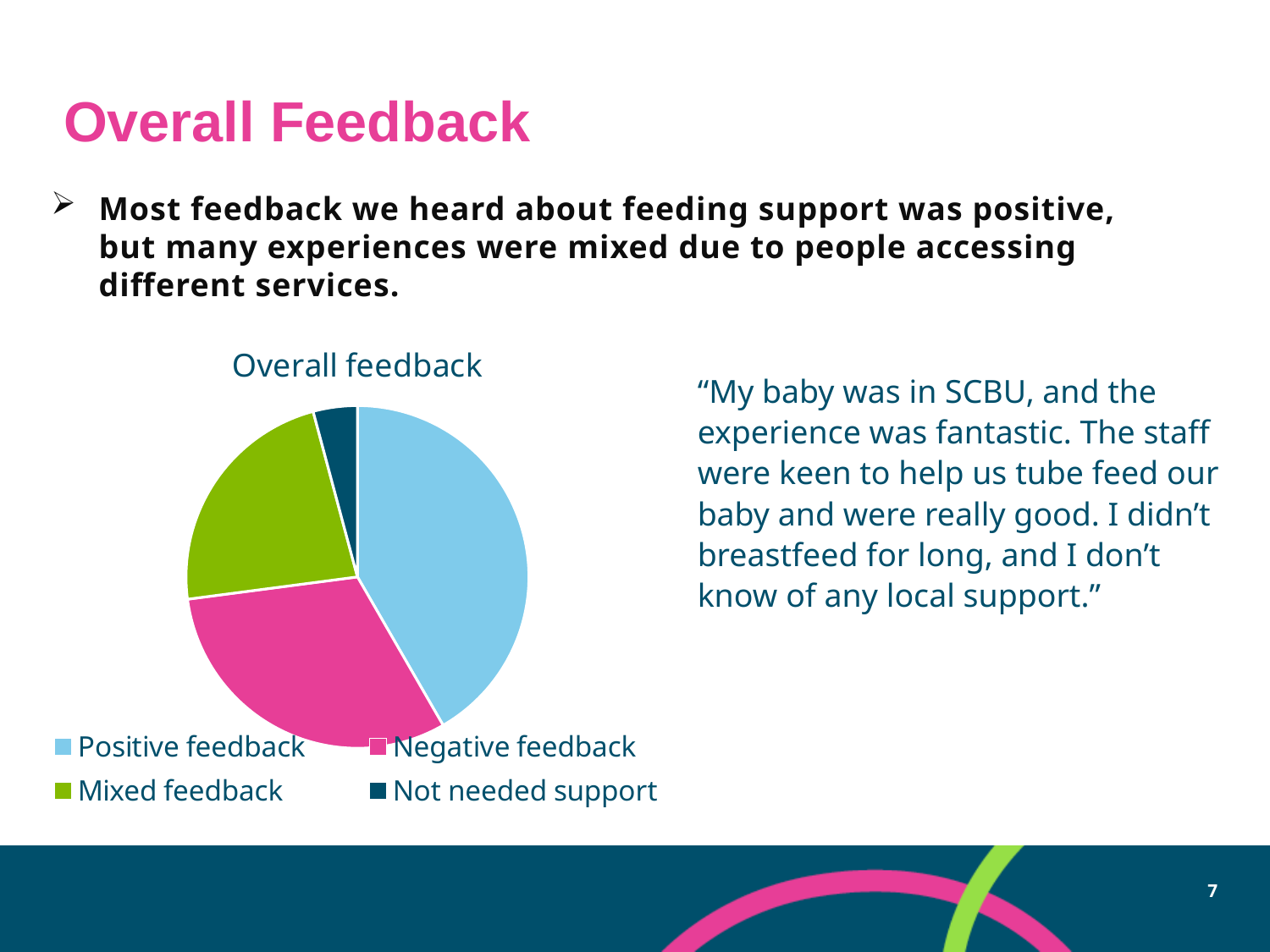
Which slice is larger, Negative feedback or Mixed feedback? Negative feedback Which category has the smallest slice of the pie? Not needed support How many entries does the chart legend list? 4 Which slice is larger, Positive feedback or Negative feedback? Positive feedback What kind of chart is shown on the slide? Pie chart Which category has the largest slice of the pie? Positive feedback How many categories does the pie chart show? 4 What is the title of the chart? Overall feedback What colour is the Negative feedback slice in the pie chart? Pink Which slice is larger, Positive feedback or Mixed feedback? Positive feedback